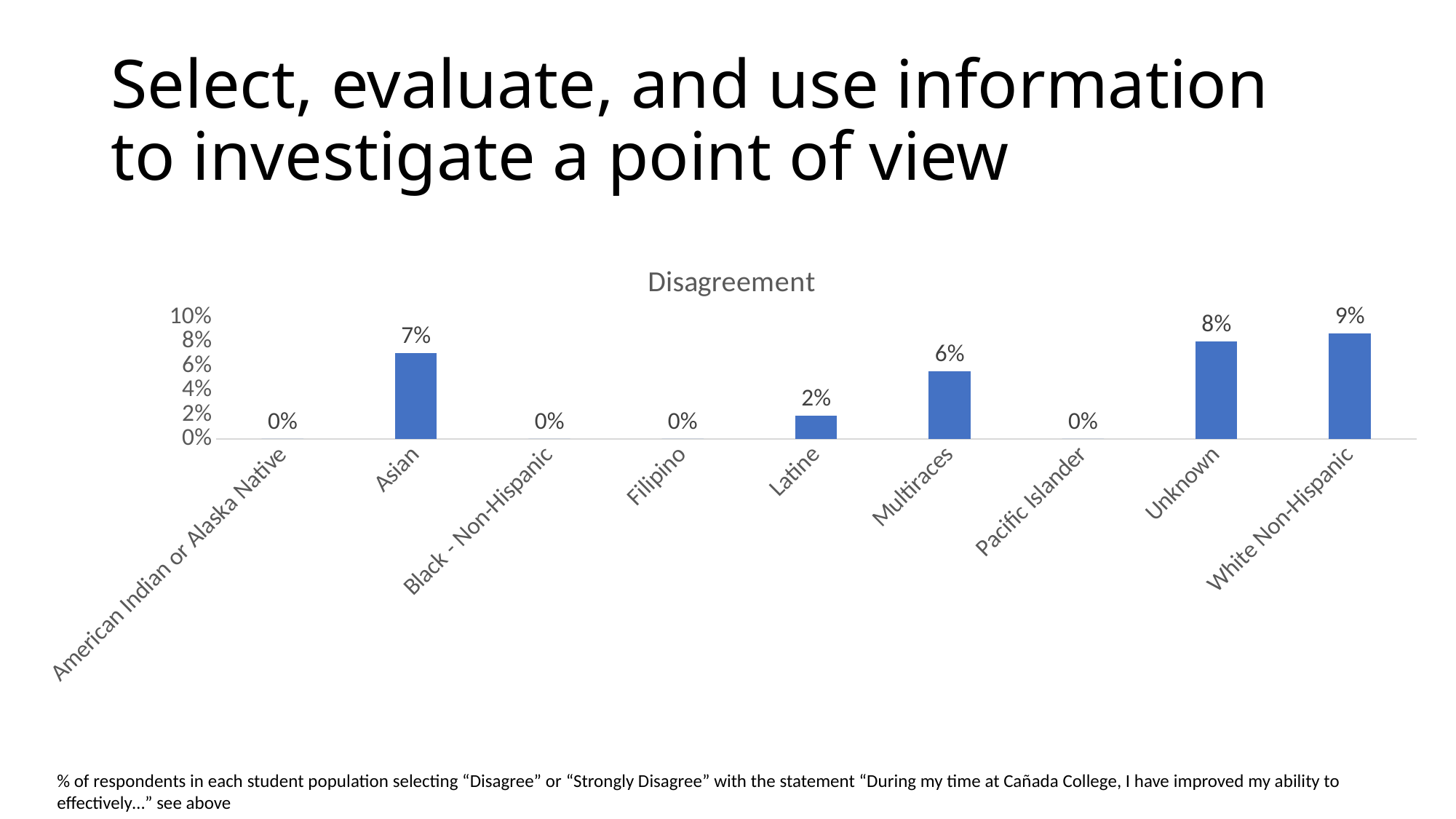
How many categories are shown on the x axis? 9 What is the title of the chart? Disagreement What is the value for Asian? 7% What is the value for Pacific Islander? 0% Which is larger, the value for Asian or the value for Multiraces? Asian What is the value for White Non-Hispanic? 9% Which category has the highest value? White Non-Hispanic What is the difference between the values for Unknown and Latine? 6% Is the value for Unknown greater or less than 4%? greater What is the value for Multiraces? 6% What kind of chart is shown? Bar chart What is the value for Latine? 2%